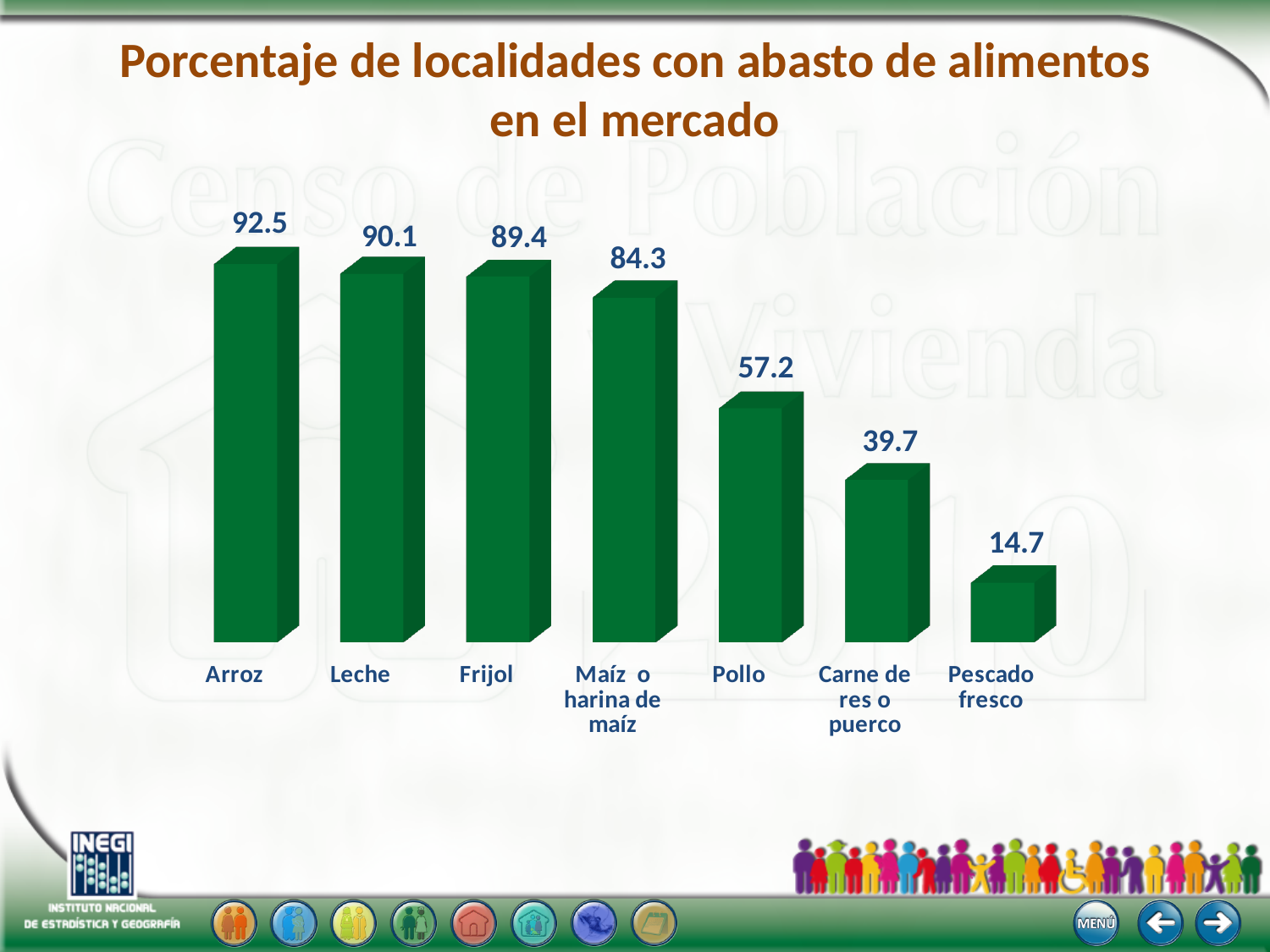
What is the value for Arroz? 92.5 What is the value for Pescado fresco? 14.7 What is the difference between the values for Leche and Frijol? 0.7 Which category has the lowest value? Pescado fresco Which is larger, the value for Carne de res o puerco or the value for Pescado fresco? Carne de res o puerco What is the difference between the values for Pollo and Carne de res o puerco? 17.5 What kind of chart is shown on the slide? Bar chart Which category has the highest value? Arroz Do the values rise or fall from left to right across the categories? Fall What is the value for Pollo? 57.2 How many categories are shown in the chart? 7 What is the value for Maíz o harina de maíz? 84.3